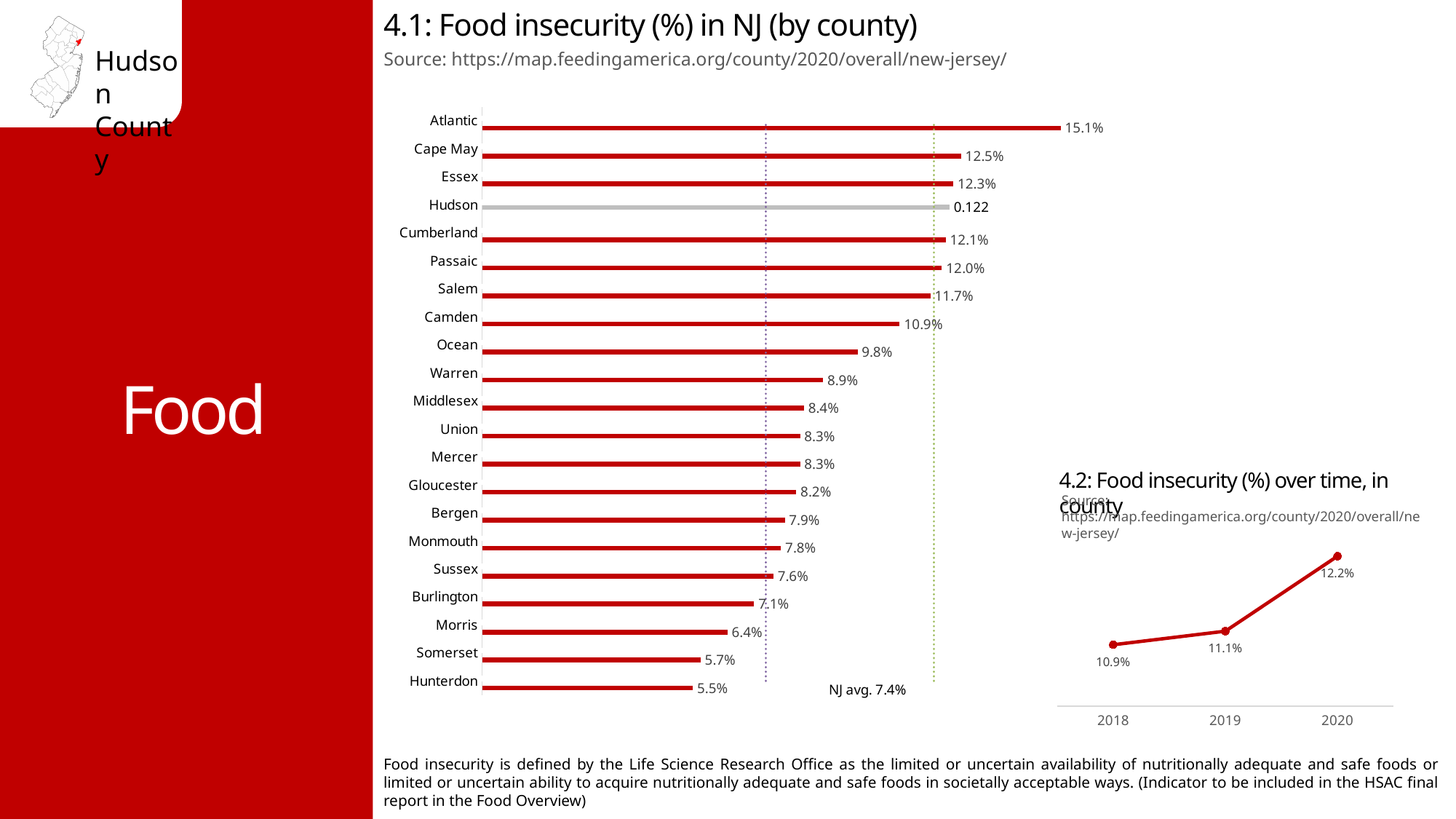
In chart 4.2 (Food insecurity over time in county), what is the difference between the 2020 and 2018 values? 1.3% In chart 4.2 (Food insecurity over time in county), what is the value for 2019? 11.1% In chart 4.1 (Food insecurity in NJ by county), which county has the lowest value? Hunterdon In chart 4.1 (Food insecurity in NJ by county), what kind of chart is it? Bar chart In chart 4.1 (Food insecurity in NJ by county), how many counties are plotted? 21 In chart 4.1 (Food insecurity in NJ by county), what is the value shown for Camden? 10.9% In chart 4.1 (Food insecurity in NJ by county), which is larger, Ocean or Warren? Ocean In chart 4.1 (Food insecurity in NJ by county), what is the value for Atlantic? 15.1% In chart 4.1 (Food insecurity in NJ by county), what NJ average is labelled on the chart? 7.4% In chart 4.1 (Food insecurity in NJ by county), which county has the highest value? Atlantic In chart 4.1 (Food insecurity in NJ by county), what is the difference between Cape May and Essex? 0.2% In chart 4.2 (Food insecurity over time in county), do the values rise or fall from 2018 to 2020? Rise